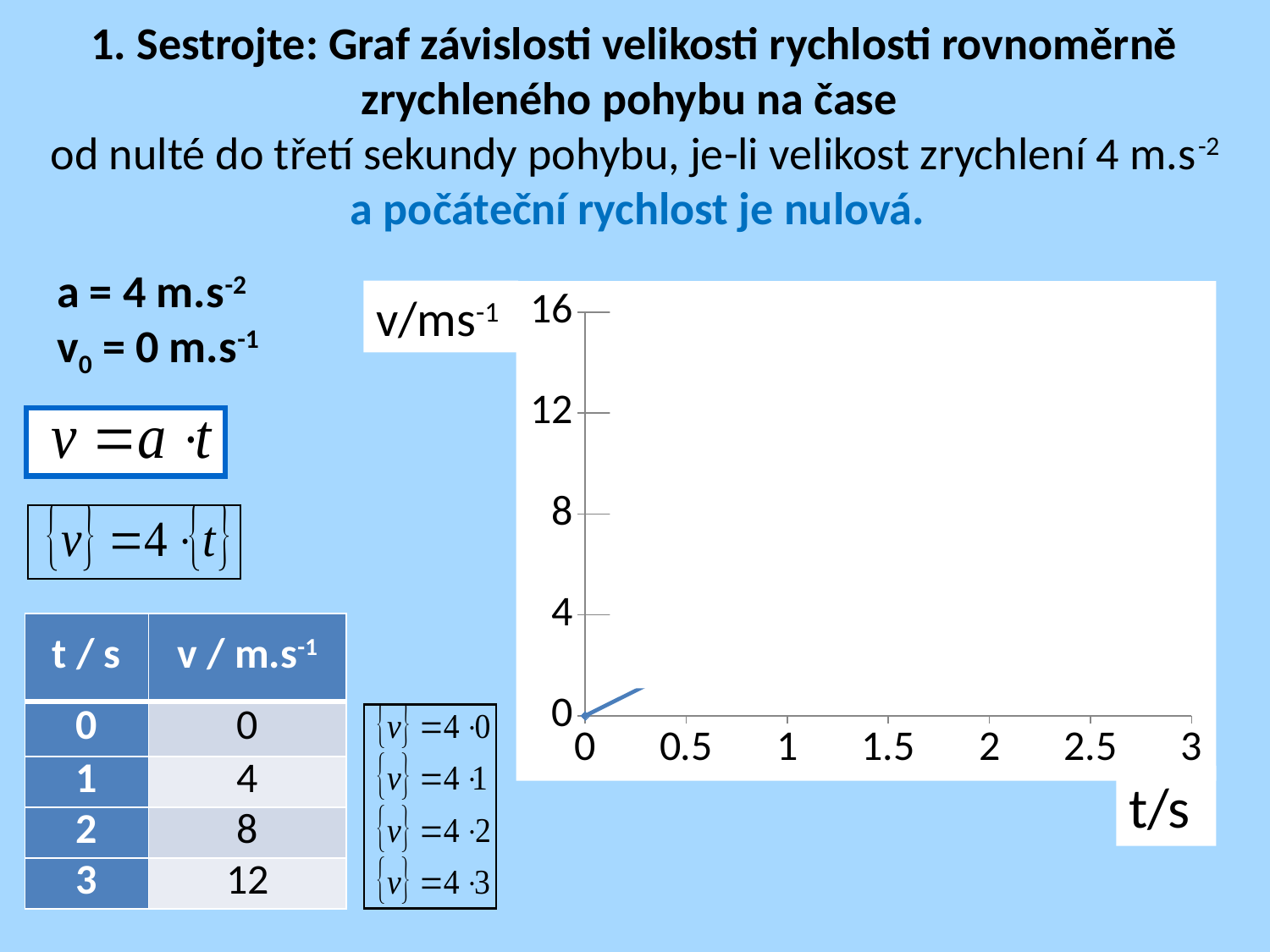
What is the label of the vertical axis of the chart? v/ms-1 What is the highest value shown on the horizontal axis of the chart? 3 What is the highest value shown on the vertical axis of the chart? 16 How many tick labels are shown on the vertical axis of the chart? 5 What is the spacing between consecutive tick labels on the vertical axis? 4 At what value of t does the plotted line start? 0 How many tick labels are shown on the horizontal axis of the chart? 7 Does the plotted line rise or fall as t increases? rise What kind of chart is shown on the slide? line chart Is the value of the plotted line at its right end greater or less than 4? less What is the label of the horizontal axis of the chart? t/s